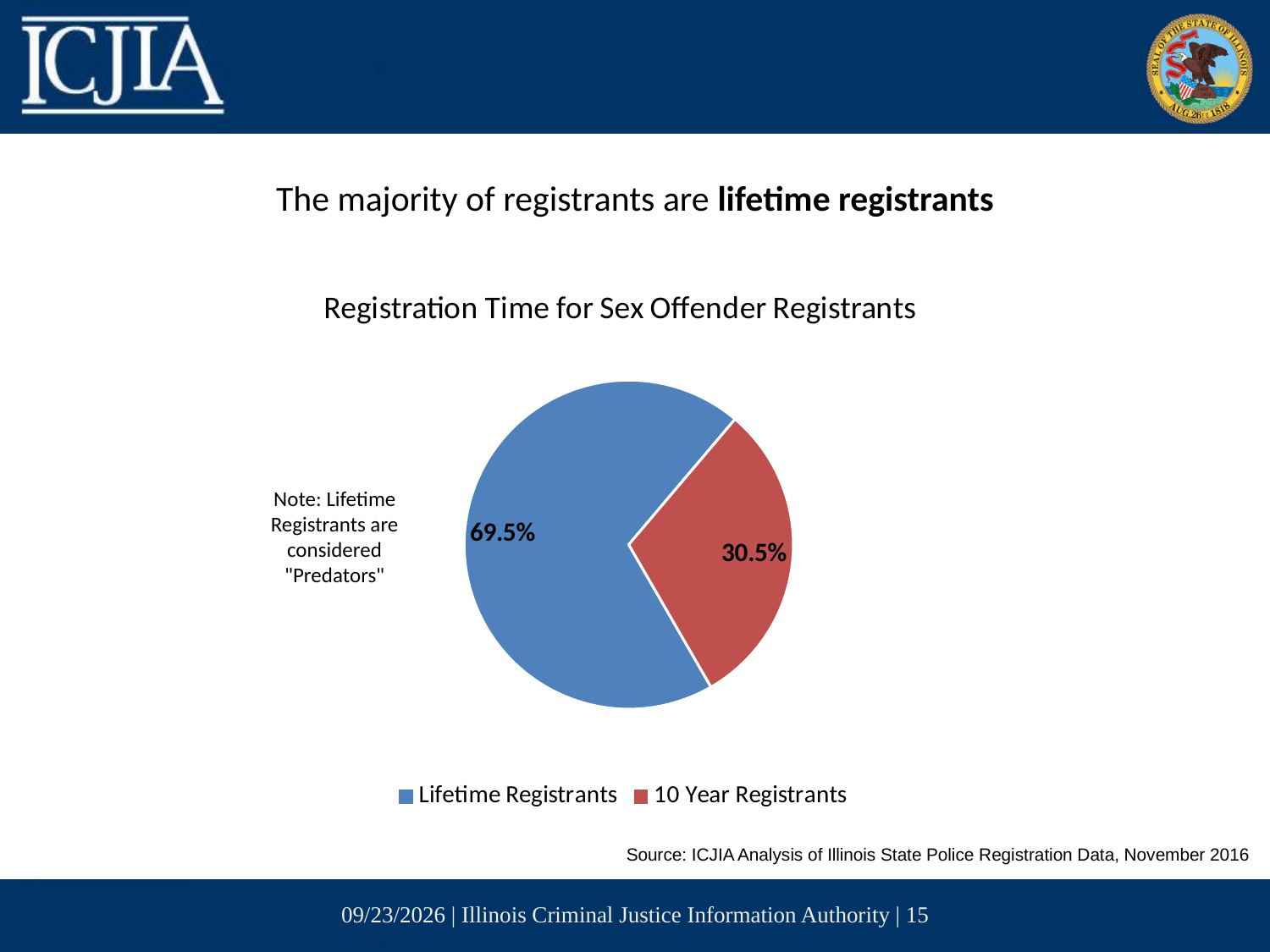
Which category has the smallest share of the pie? 10 Year Registrants What type of chart is shown on the slide? Pie chart What percentage of registrants are Lifetime Registrants? 69.5% How many slices does the pie chart have? 2 What is the difference in percentage points between Lifetime Registrants and 10 Year Registrants? 39 percentage points What colour is the slice for 10 Year Registrants? Red Which is larger: the share of Lifetime Registrants or the share of 10 Year Registrants? Lifetime Registrants How many entries does the legend list? 2 Which category has the largest share of the pie? Lifetime Registrants What percentage of registrants are 10 Year Registrants? 30.5% What is the title of the chart? Registration Time for Sex Offender Registrants